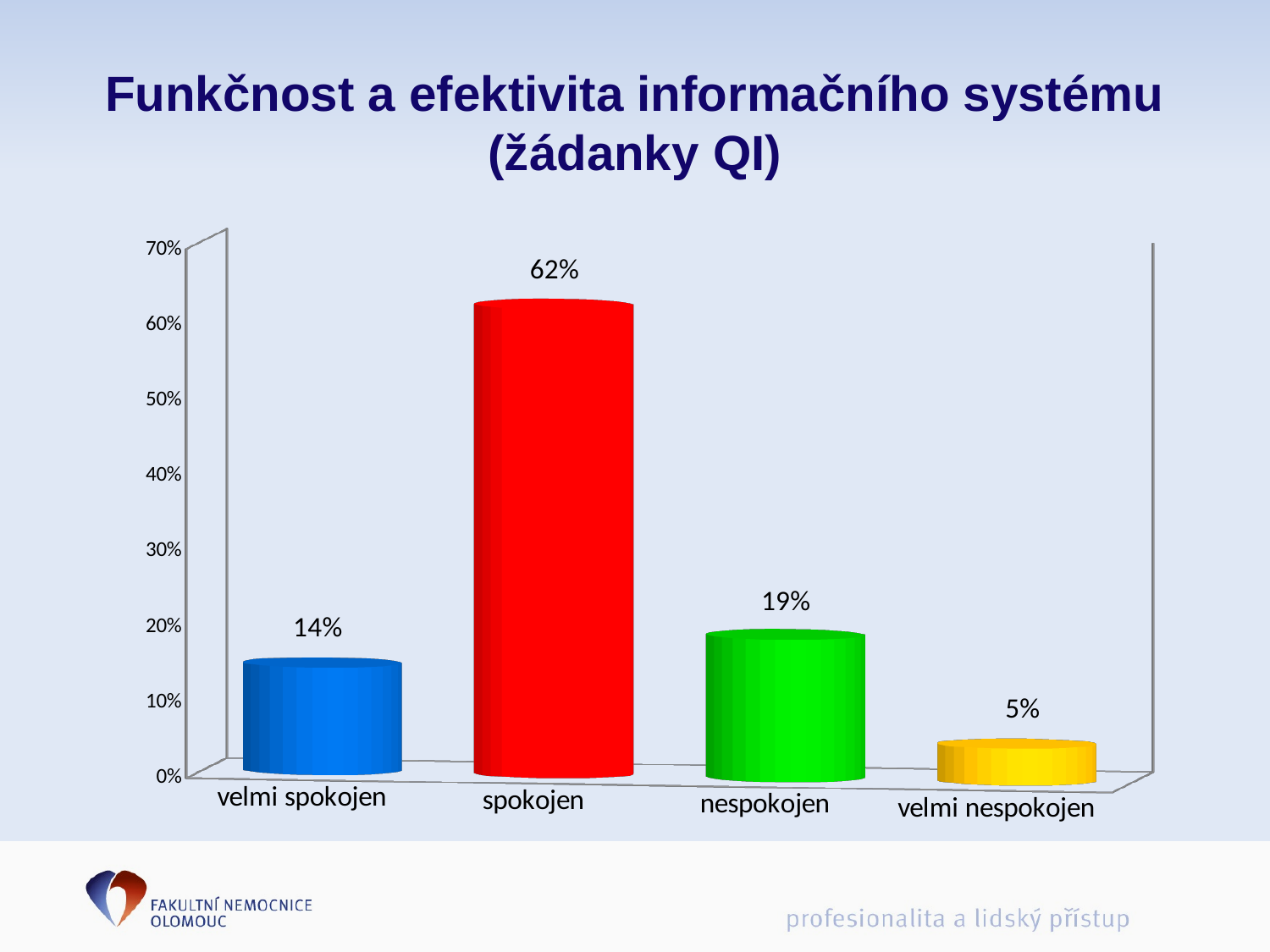
What is the value for "nespokojen"? 19% What is the value for "velmi nespokojen"? 5% Which is larger, the value for "nespokojen" or the value for "velmi spokojen"? nespokojen What is the value for "spokojen"? 62% What is the difference between the values for "spokojen" and "nespokojen"? 43% What is the value for "velmi spokojen"? 14% Which category has the lowest value? velmi nespokojen What is the title of the chart? Funkčnost a efektivita informačního systému (žádanky QI) What kind of chart is shown on the slide? bar chart Which category has the highest value? spokojen What is the difference between the values for "nespokojen" and "velmi spokojen"? 5% How many categories are shown on the x axis? 4